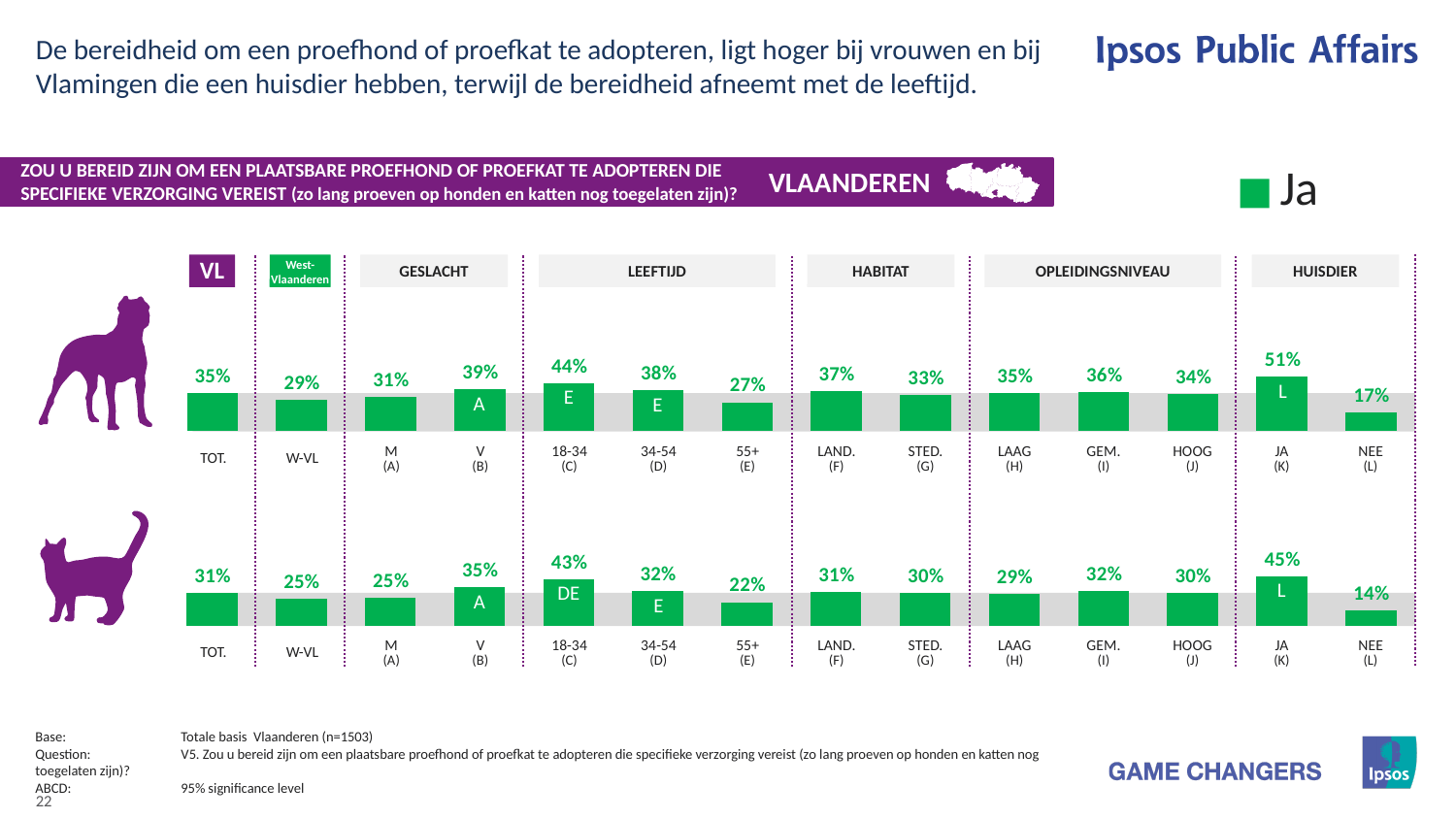
In the top chart (dog), what is the difference between the values for V (B) and M (A)? 8% What is the single legend entry shown on the slide? Ja In the top chart (dog), which category has the highest value? JA (K) What kind of chart is used on this slide? Bar chart How many bars are shown in the top chart (dog)? 14 In the bottom chart (cat), what is the difference between the values for JA (K) and NEE (L)? 31% In the top chart (dog), do the values rise or fall across the age groups from 18-34 to 55+? Fall In the top chart (dog), which is larger: the value for LAND. (F) or STED. (G)? LAND. (F) In the bottom chart (cat), which is larger: the value for 34-54 (D) or 55+ (E)? 34-54 (D) In the bottom chart (cat), which category has the lowest value? NEE (L) In the top chart (dog), what is the value for TOT.? 35% In the bottom chart (cat), what is the value for the 18-34 age group? 43%